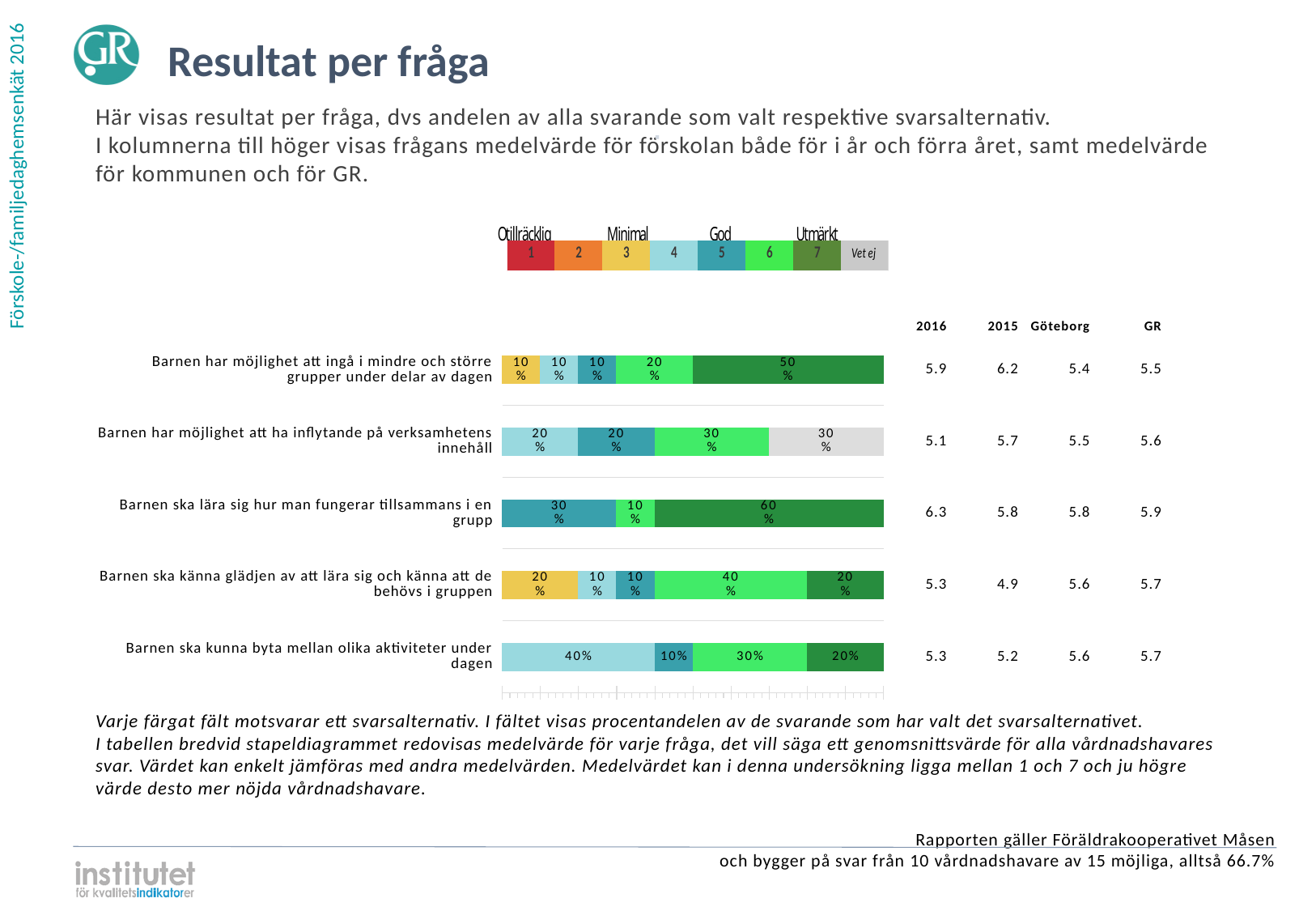
What is the difference between the 2016 and 2015 mean values for 'Barnen ska känna glädjen av att lära sig och känna att de behövs i gruppen'? 0.4 Which question has the largest share of respondents choosing answer 7 (dark green)? Barnen ska lära sig hur man fungerar tillsammans i en grupp Which is larger for 'Barnen har möjlighet att ingå i mindre och större grupper under delar av dagen': the 2016 mean or the 2015 mean? 2015 mean What percentage of respondents chose answer 7 (dark green) for 'Barnen ska lära sig hur man fungerar tillsammans i en grupp'? 60% What percentage chose 'Vet ej' for 'Barnen har möjlighet att ha inflytande på verksamhetens innehåll'? 30% How many questions (bars) are shown in the chart? 5 What kind of chart is used to show the results per question? Stacked bar chart What label does the legend give to answer alternatives 1 and 2? Otillräcklig What is the 2016 mean value for 'Barnen ska lära sig hur man fungerar tillsammans i en grupp'? 6.3 What percentage chose answer 4 (light blue) for 'Barnen ska kunna byta mellan olika aktiviteter under dagen'? 40% What percentage chose answer 6 (bright green) for 'Barnen ska känna glädjen av att lära sig och känna att de behövs i gruppen'? 40% How many answer alternatives does the legend above the chart list? 8